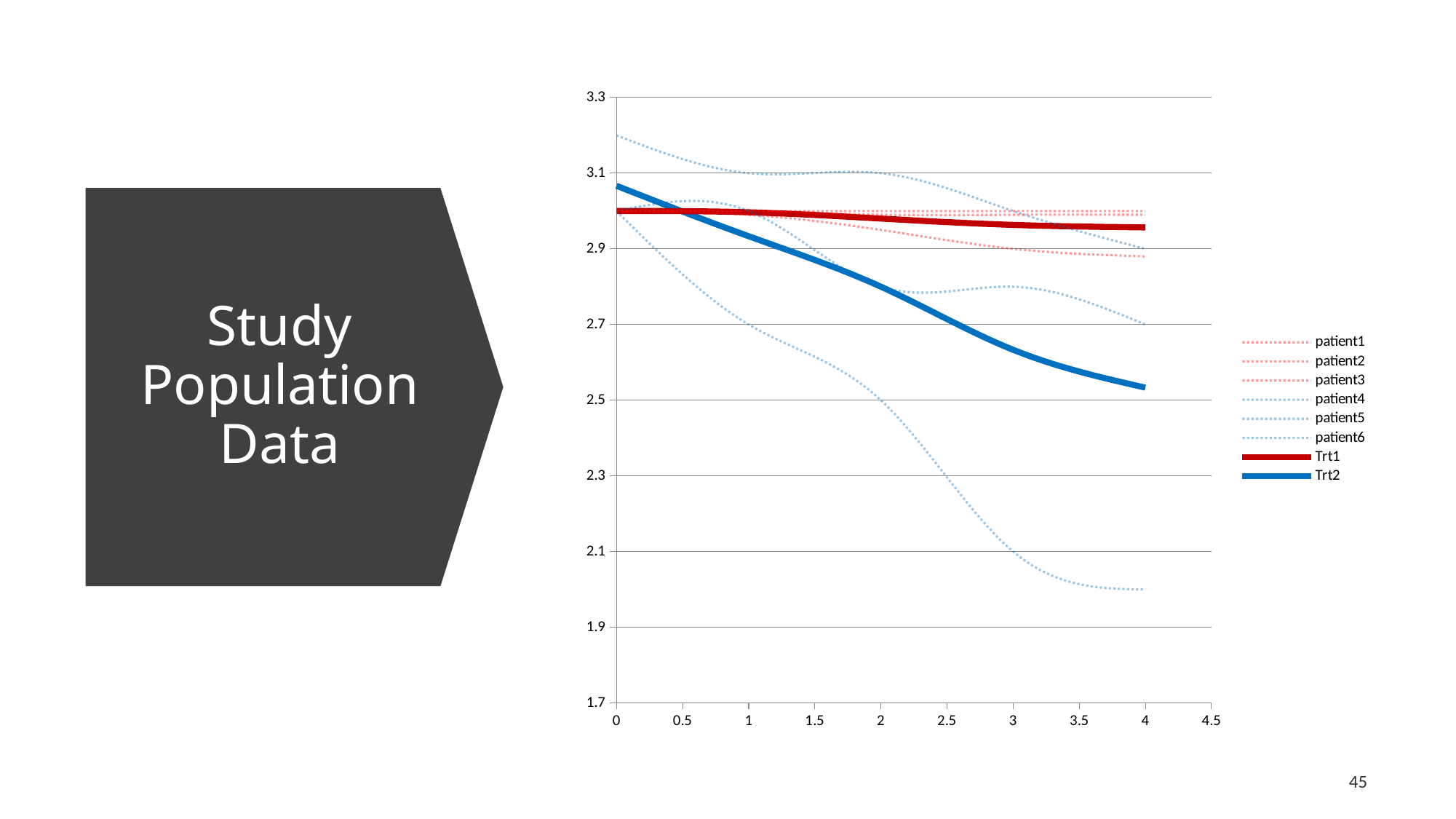
Is the value of Trt2 at x = 0 greater or less than 2.9? greater Does the Trt2 line rise or fall as x increases from 0 to 4? fall How many series does the legend list? 8 Is the value of Trt2 at x = 4 greater or less than 2.7? less Does the Trt1 line rise or fall as x increases from 0 to 4? fall What kind of chart is shown on the slide? line chart At x = 4, which series has the larger value, Trt1 or Trt2? Trt1 What colour is the Trt2 line in the legend? blue Is the value of patient6 at x = 4 greater or less than 2.1? less Which series reaches the lowest value on the chart? patient6 How many patient series are listed in the legend? 6